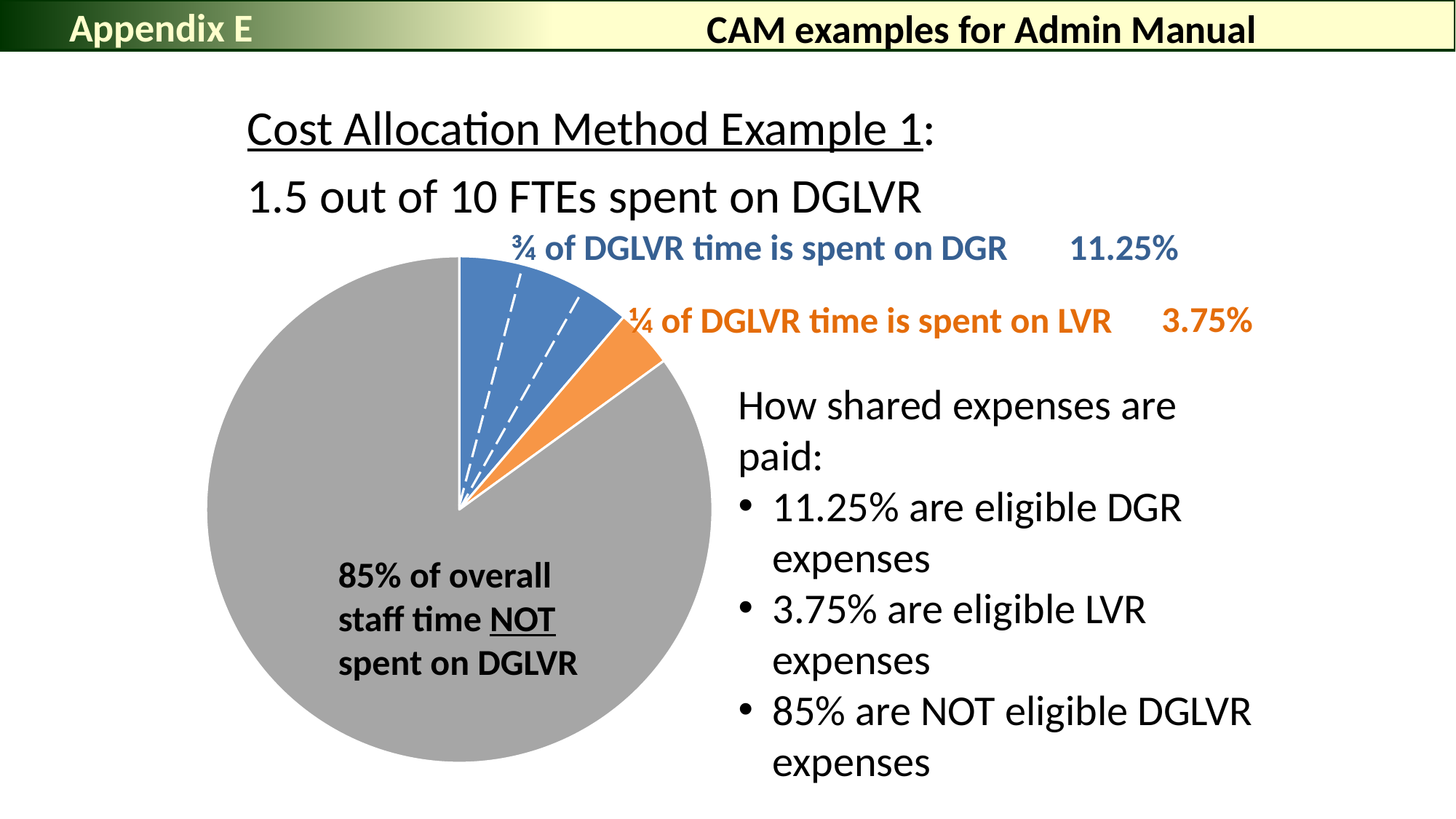
What colour is the slice representing DGLVR time spent on LVR? orange What colour is the slice representing DGLVR time spent on DGR? blue What share of the pie is labelled as overall staff time NOT spent on DGLVR? 85% How many slices does the pie chart have? 3 Which is larger, the DGR slice or the LVR slice? DGR What percentage is shown for DGLVR time spent on LVR? 3.75% Which slice of the pie chart is the smallest? LVR (3.75%) What kind of chart is shown on the slide? pie chart What is the difference between the DGR percentage and the LVR percentage? 7.5% What percentage is shown for DGLVR time spent on DGR? 11.25% Which slice of the pie chart is the largest? 85% of overall staff time NOT spent on DGLVR What is the combined percentage of the DGR and LVR slices? 15%